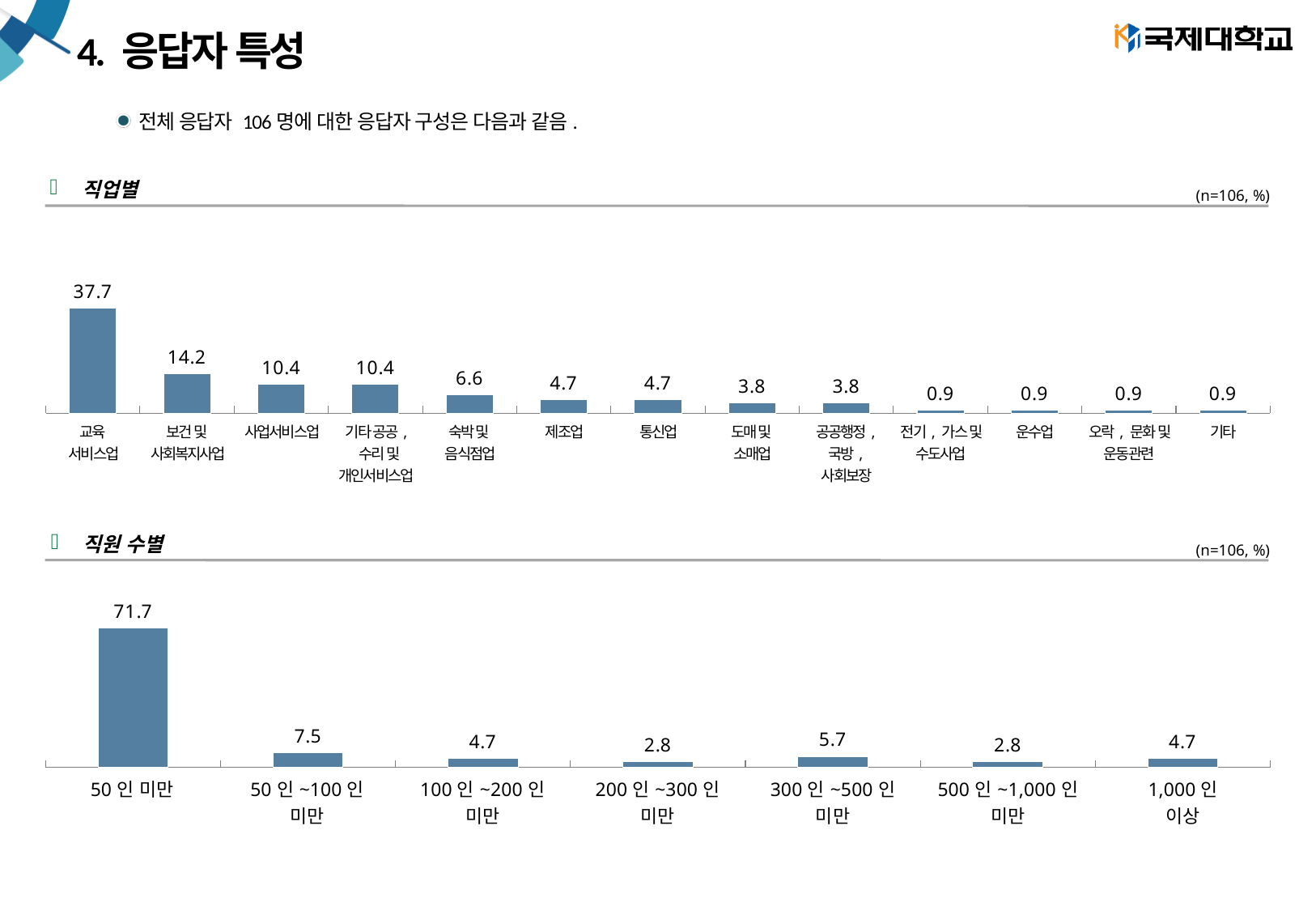
What type of chart is the 직원 수별 chart? Bar chart In the 직원 수별 chart, what is the value for 300인~500인 미만? 5.7 In the 직업별 chart, what is the value for 보건 및 사회복지사업? 14.2 In the 직업별 chart, which category has the highest value? 교육 서비스업 In the 직원 수별 chart, which category has the highest value? 50인 미만 In the 직원 수별 chart, how many categories are shown? 7 In the 직원 수별 chart, what is the difference between 50인~100인 미만 and 200인~300인 미만? 4.7 In the 직업별 chart, what is the difference between 교육 서비스업 and 보건 및 사회복지사업? 23.5 In the 직업별 chart, which is larger, 숙박 및 음식점업 or 제조업? 숙박 및 음식점업 In the 직업별 chart, how many categories are shown? 13 In the 직원 수별 chart, what is the value for 50인 미만? 71.7 In the 직업별 chart, what is the value for 교육 서비스업? 37.7